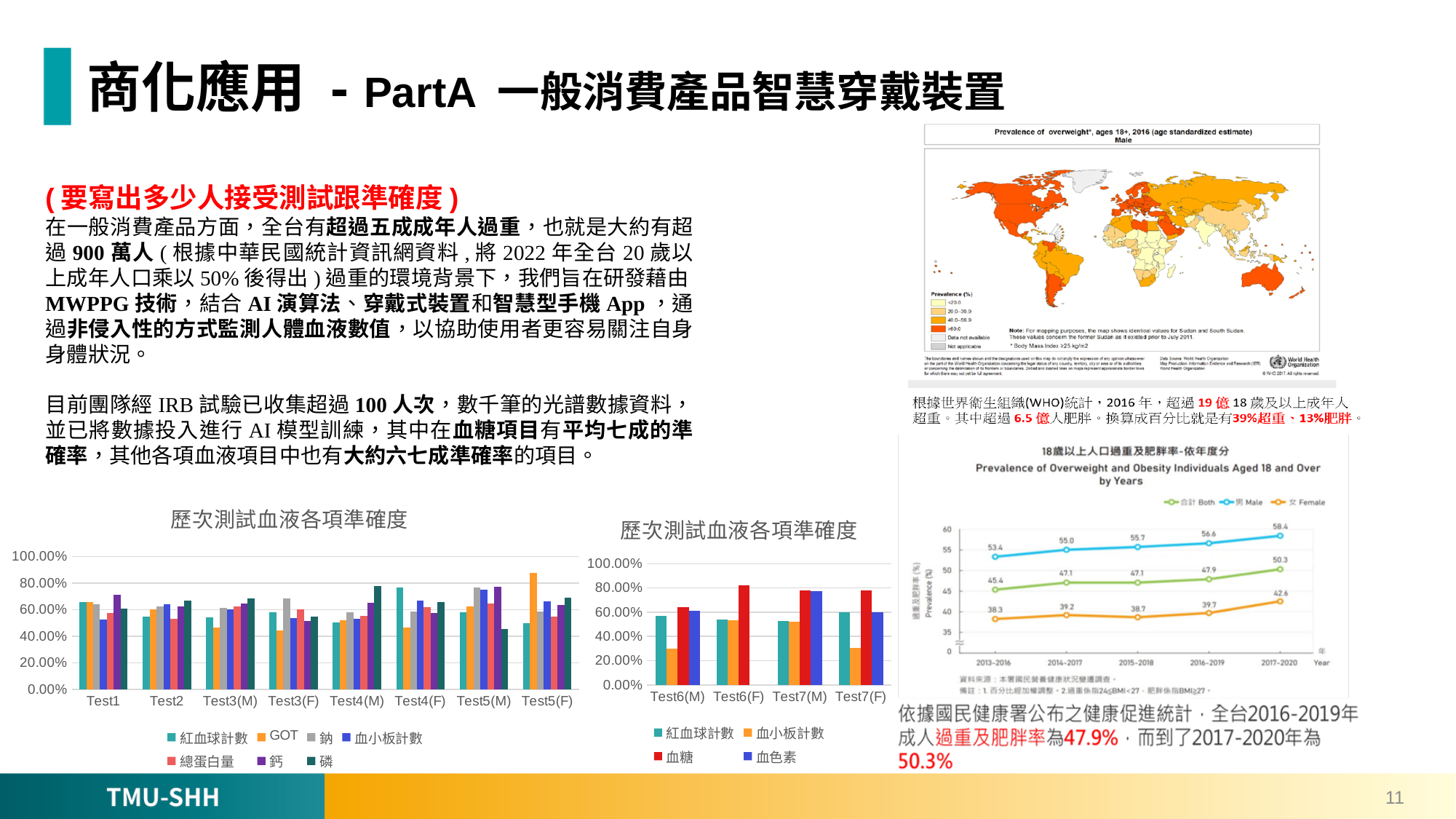
In the line chart 'Prevalence of Overweight and Obesity Individuals Aged 18 and Over by Years', what is the difference between the Male and Female values for 2017-2020? 15.8 In the line chart 'Prevalence of Overweight and Obesity Individuals Aged 18 and Over by Years', what is the Male value for 2017-2020? 58.4 In the left bar chart '歷次測試血液各項準確度' (Test1 to Test5(F)), how many series does the legend list? 7 In the line chart 'Prevalence of Overweight and Obesity Individuals Aged 18 and Over by Years', what is the Female value for 2013-2016? 38.3 In the middle bar chart '歷次測試血液各項準確度' (Test6(M) to Test7(F)), is the 血小板計數 value for Test6(M) greater or less than 40.00%? less In the left bar chart '歷次測試血液各項準確度' (Test1 to Test5(F)), how many test categories are shown on the x axis? 8 In the line chart 'Prevalence of Overweight and Obesity Individuals Aged 18 and Over by Years', which year period has the highest Male value? 2017-2020 How many series does the legend of the line chart 'Prevalence of Overweight and Obesity Individuals Aged 18 and Over by Years' list? 3 In the line chart 'Prevalence of Overweight and Obesity Individuals Aged 18 and Over by Years', what is the Both value for 2016-2019? 47.9 In the left bar chart '歷次測試血液各項準確度' (Test1 to Test5(F)), is the GOT value for Test5(F) greater or less than 80.00%? greater What kind of chart is the middle chart '歷次測試血液各項準確度' (Test6(M) to Test7(F))? bar chart In the line chart 'Prevalence of Overweight and Obesity Individuals Aged 18 and Over by Years', does the Male series rise or fall from 2013-2016 to 2017-2020? rise